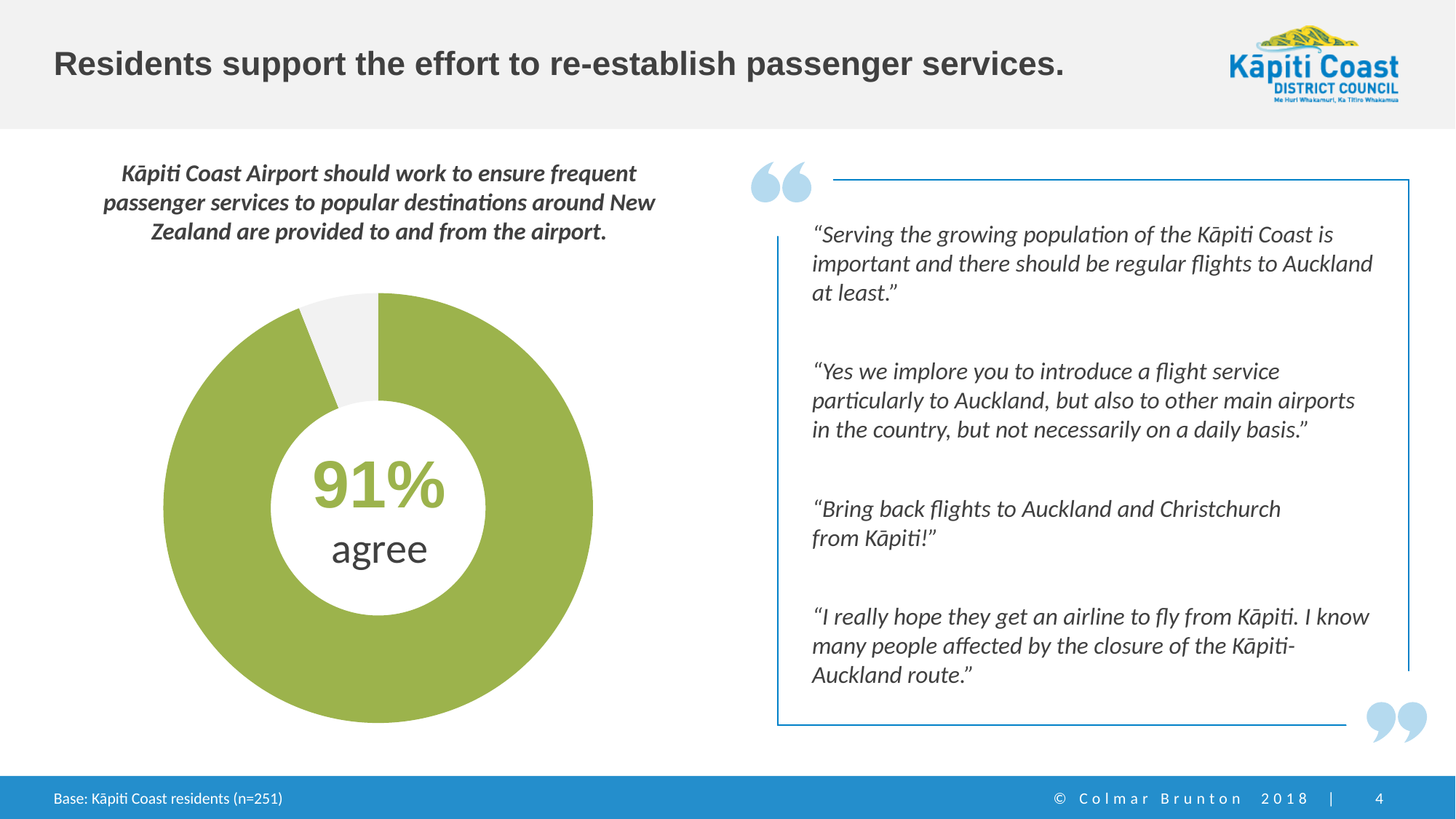
What percentage of residents agree that Kāpiti Coast Airport should work to ensure frequent passenger services, according to the donut chart? 91% How many segments does the donut chart have? 2 What colour is the segment representing residents who agree? Green What kind of chart is shown on the left of the slide? Pie (donut) chart Is the share of residents who agree greater or less than 50%? greater Which segment of the donut chart is larger, the green one or the grey one? The green one What word is printed beneath the 91% figure in the centre of the donut chart? agree